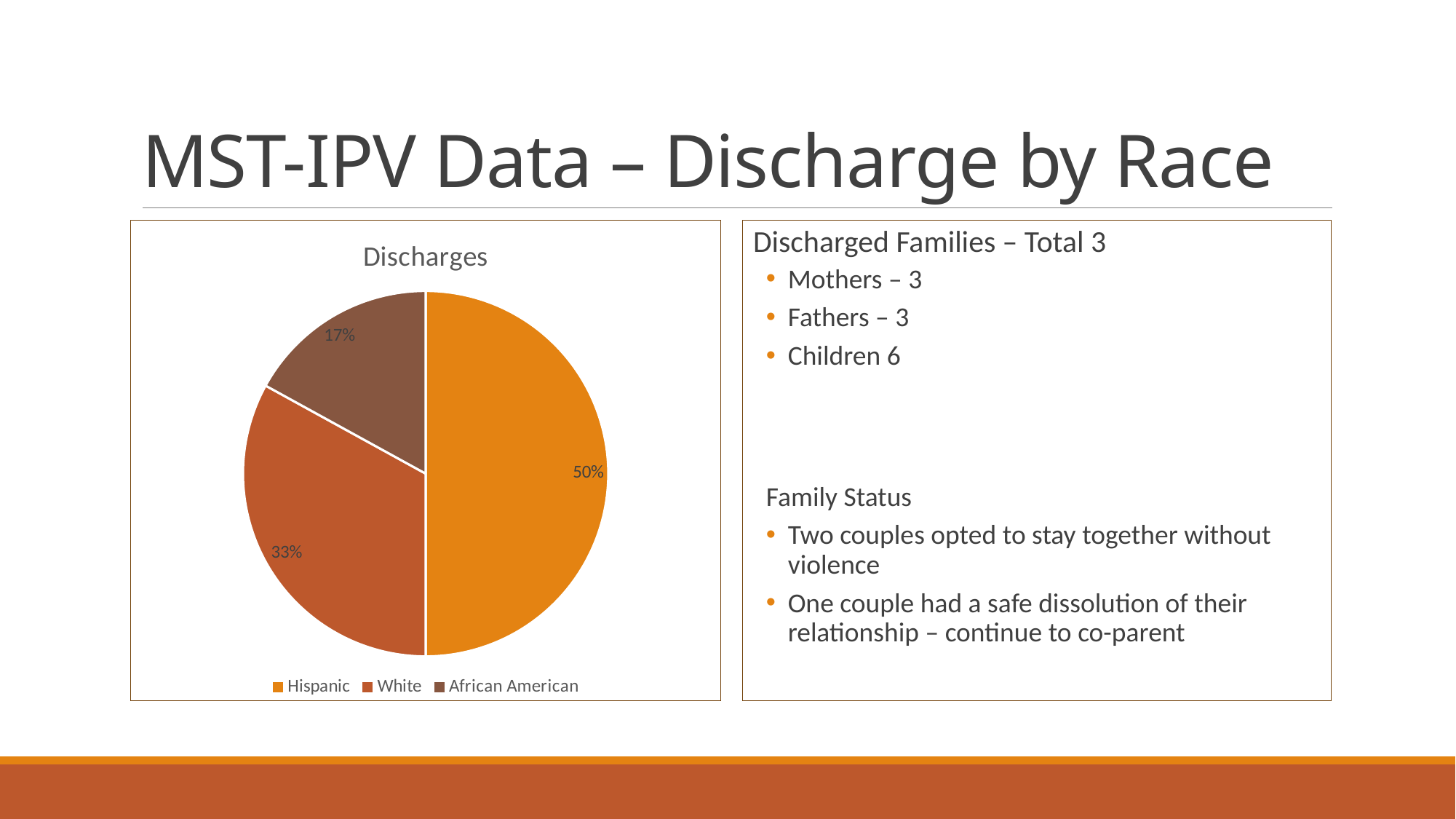
What share of discharges is White? 33% What share of discharges is Hispanic? 50% What share of discharges is African American? 17% What type of chart is shown on the slide? pie chart Which race has the largest share of discharges? Hispanic What is the difference in percentage points between the Hispanic and White shares? 17 Which category is shown in the darkest brown colour in the legend? African American Which is larger, the White share or the African American share? White What is the difference in percentage points between the White and African American shares? 16 Which race has the smallest share of discharges? African American What is the title of the chart? Discharges How many categories does the pie chart show? 3